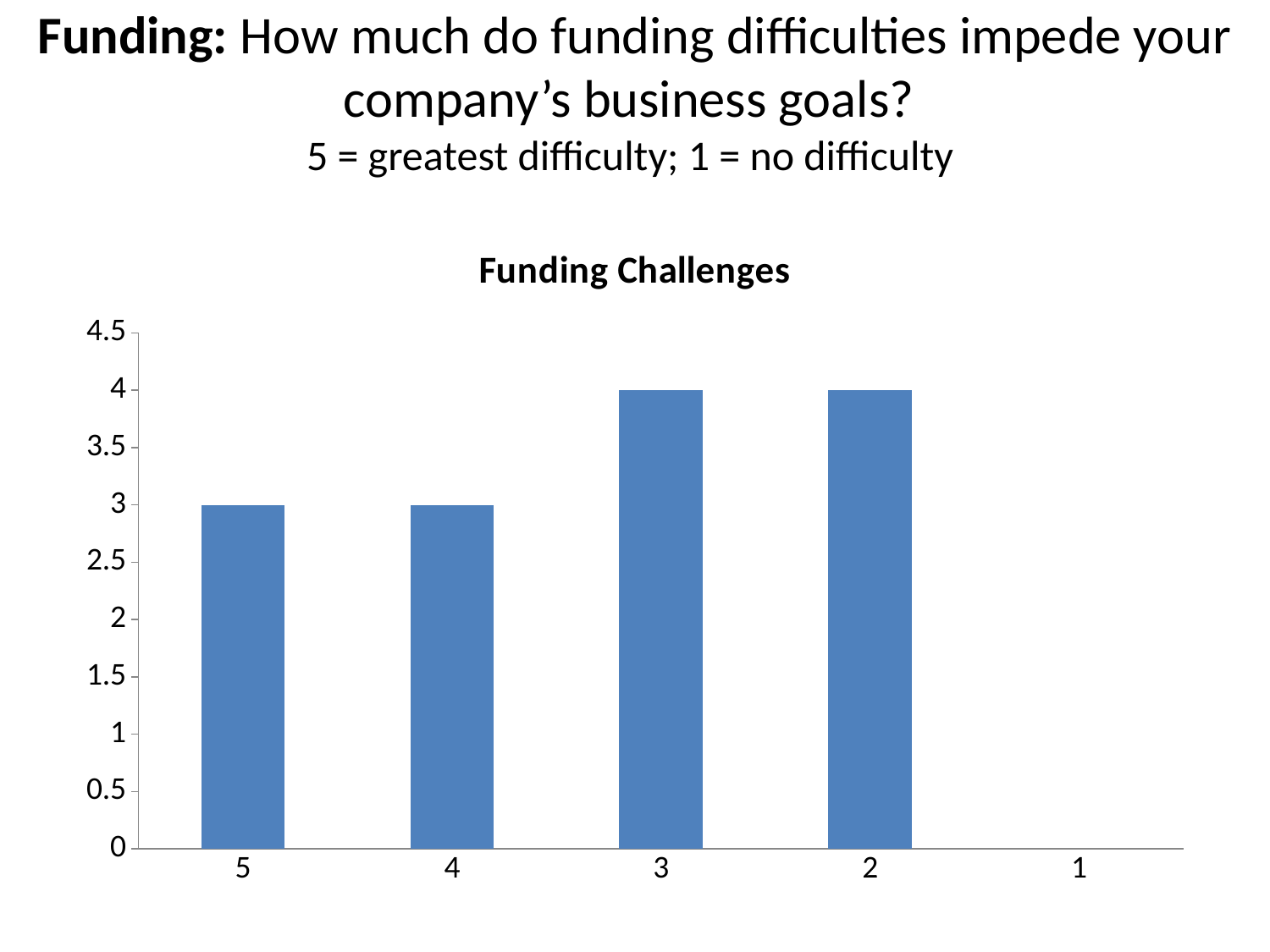
What kind of chart is shown on the slide? bar chart Is the value for category 3 greater or less than 3.5? greater What is the difference between the value for category 3 and the value for category 5? 1 What is the value for category 5 in the Funding Challenges chart? 3 What is the value for category 2 in the Funding Challenges chart? 4 Is the value for category 5 greater or less than 3.5? less What is the value for category 4 in the Funding Challenges chart? 3 What is the title of the chart? Funding Challenges How many categories are labelled on the x axis of the chart? 5 What is the highest value labelled on the y axis of the chart? 4.5 What is the value for category 3 in the Funding Challenges chart? 4 Which has the larger value, category 2 or category 4? 2